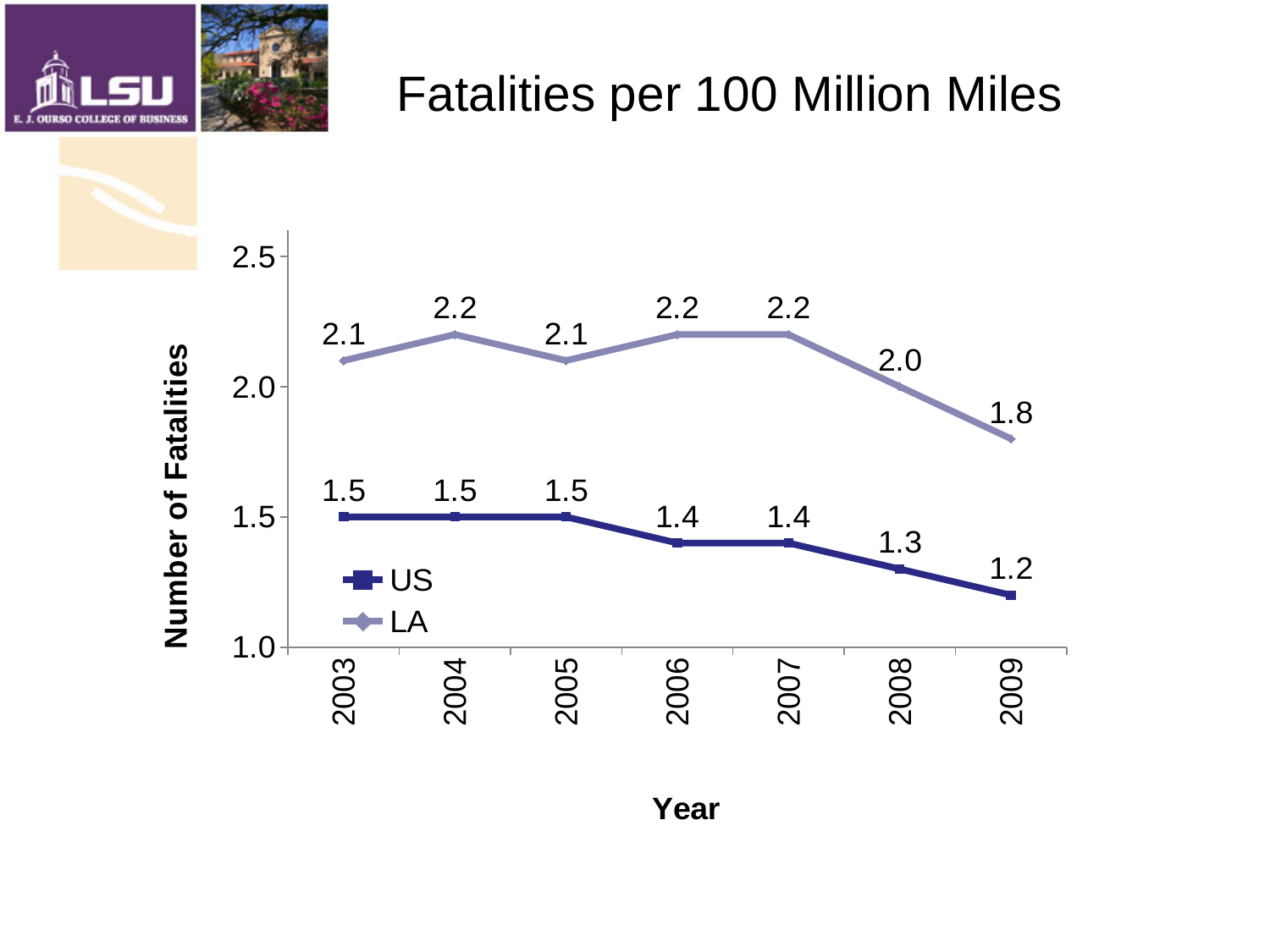
What kind of chart is shown? Line chart In which year is the LA value lowest? 2009 How many years are shown on the x axis? 7 Does the US series rise or fall from 2005 to 2009? Fall How many series does the legend list? 2 In which year is the US value lowest? 2009 What is the US value for 2006? 1.4 What is the difference between the LA and US values in 2003? 0.6 What is the LA value for 2009? 1.8 Which is larger in 2005, the LA value or the US value? LA What is the difference between the LA value in 2007 and the LA value in 2009? 0.4 What is the LA value for 2008? 2.0